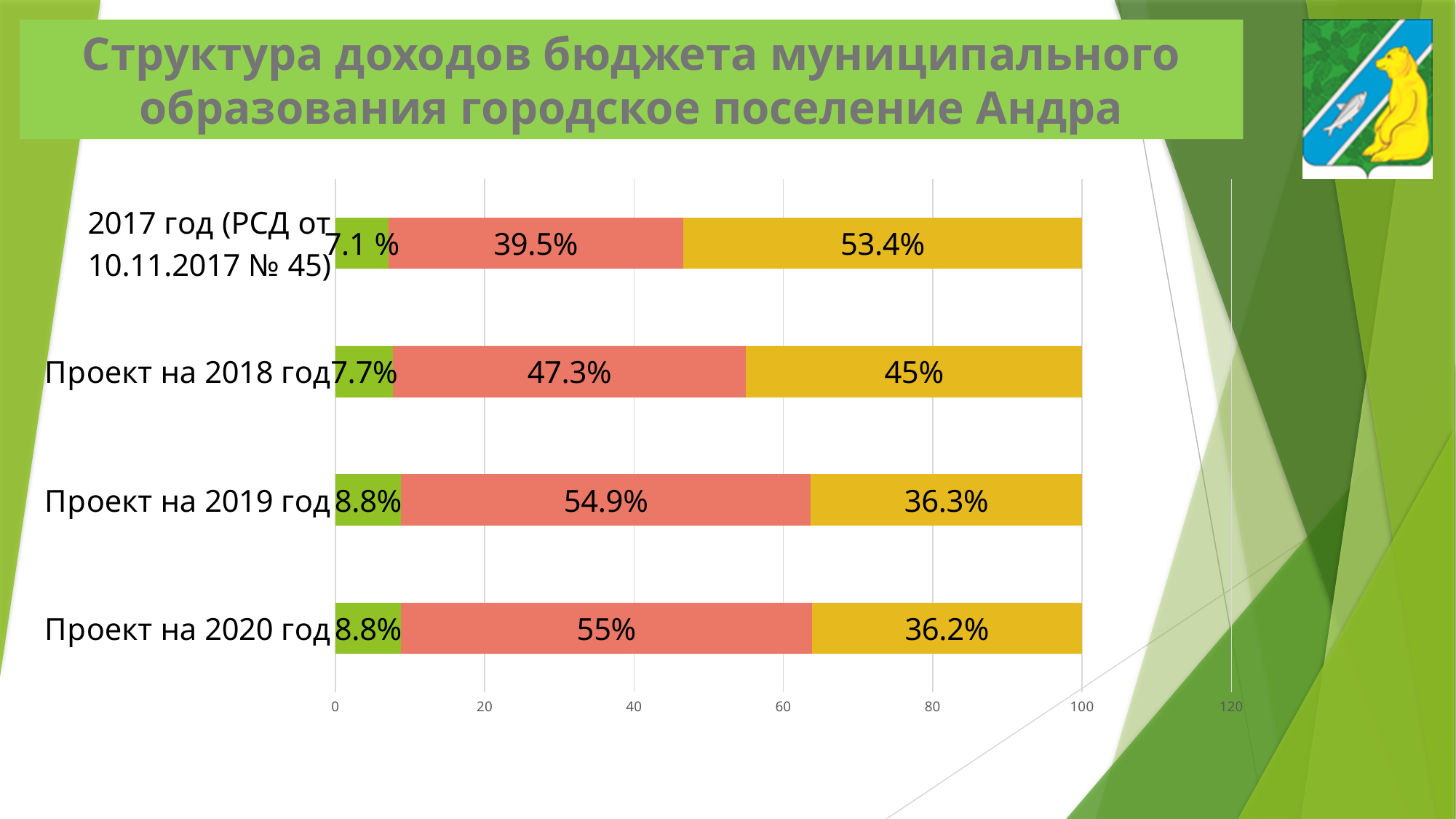
By how much is the red segment for "Проект на 2019 год" larger than the red segment for "2017 год (РСД от 10.11.2017 № 45)"? 15.4% What is the value of the green segment for "Проект на 2019 год"? 8.8% What is the total of the stacked bar for "2017 год (РСД от 10.11.2017 № 45)"? 100% What kind of chart is shown on the slide? Stacked horizontal bar chart How many categories (bars) are shown in the chart? 4 Which category has the largest yellow segment? 2017 год (РСД от 10.11.2017 № 45) What is the value of the red segment for "2017 год (РСД от 10.11.2017 № 45)"? 39.5% How many coloured segments make up each bar? 3 For "Проект на 2018 год", which is larger: the red segment or the yellow segment? The red segment (47.3%) What is the value of the yellow segment for "Проект на 2018 год"? 45% Which category has the smallest green segment? 2017 год (РСД от 10.11.2017 № 45) Does the red segment rise or fall from "2017 год" down to "Проект на 2020 год"? Rises